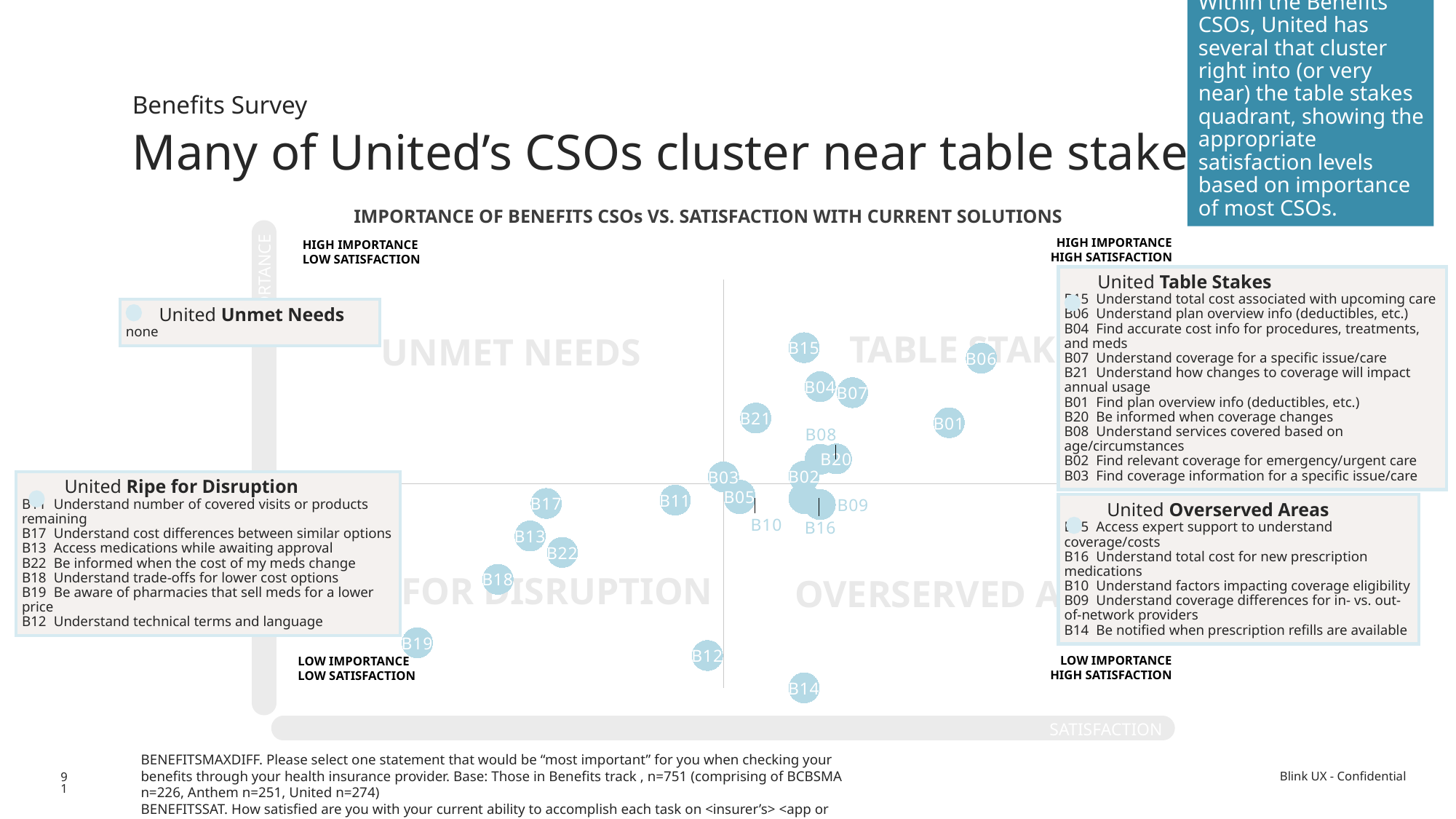
Which data point has the lowest importance (is plotted lowest on the chart)? B14 Which quadrant of the chart does B01 fall in? Table Stakes What kind of chart is shown on the slide? Scatter chart Which has higher satisfaction, B18 or B22? B22 Which quadrant of the chart does B19 fall in? Ripe for Disruption How many of United's CSOs are listed in the Unmet Needs quadrant? none Which quadrant of the chart does B14 fall in? Overserved Areas Which data point has the lowest satisfaction (is plotted furthest left)? B19 How many labeled data points are plotted on the chart? 22 What is the title of the chart? IMPORTANCE OF BENEFITS CSOs VS. SATISFACTION WITH CURRENT SOLUTIONS Which data point has the highest satisfaction (is plotted furthest right)? B06 Which has higher importance, B19 or B14? B19